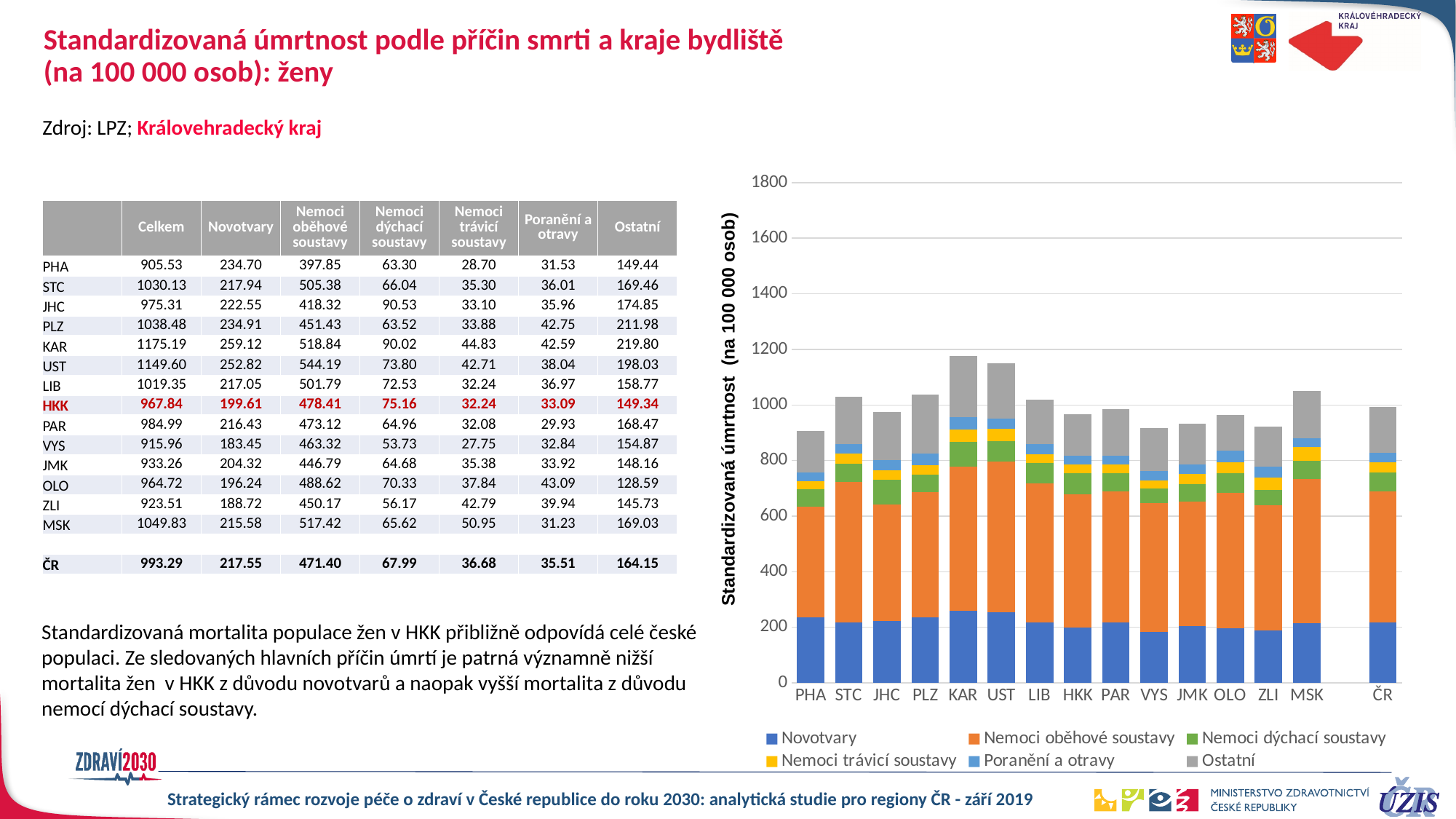
What kind of chart is shown on the slide? stacked bar chart Using the table values, what is the difference between the Celkem value for ČR and for HKK? 25.45 Is the total standardized mortality for HKK greater or less than 1000? less According to the table, what is the Novotvary value for ČR? 217.55 According to the table, what is the total (Celkem) standardized mortality for HKK? 967.84 How many series does the chart legend list? 6 What is the label of the chart's y axis? Standardizovaná úmrtnost (na 100 000 osob) Which bar is taller, KAR or HKK? KAR Is the total standardized mortality for VYS greater or less than 1000? less Is the total standardized mortality for KAR greater or less than 1000? greater Which bar is taller, STC or VYS? STC How many regions (bars) are shown along the x axis of the chart? 15